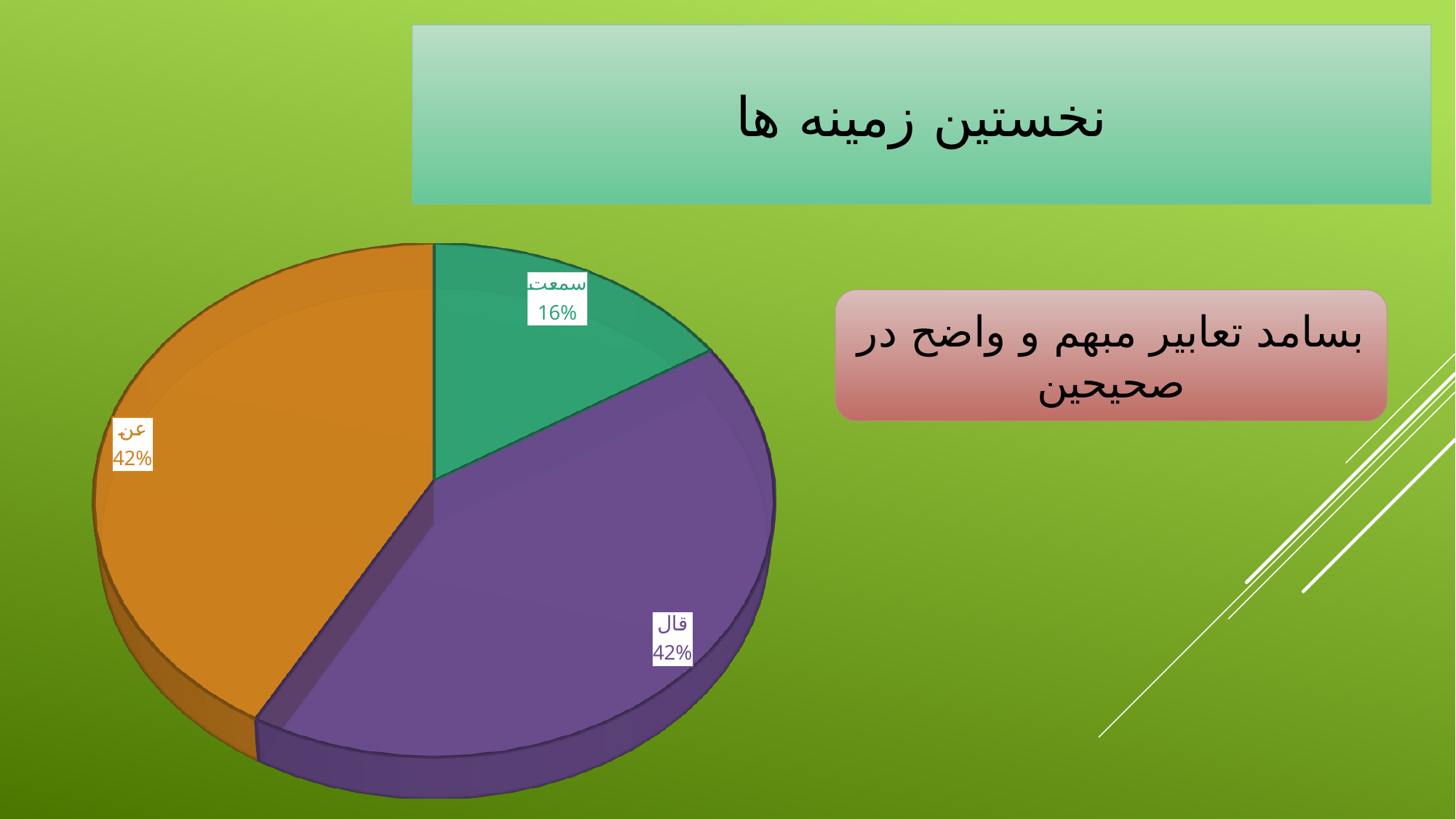
What colour is the سمعت slice? green What percentage is shown for the سمعت slice? 16% How many slices does the pie chart have? 3 What percentage is shown for the عن slice? 42% Which two slices of the pie chart have the same percentage? قال and عن What share of the pie does the عن slice represent? 42% What percentage is shown for the قال slice? 42% Which is larger, the قال slice or the سمعت slice? قال What kind of chart is shown on the slide? pie chart What colour is the قال slice? purple Which slice of the pie chart is the smallest? سمعت What is the difference in percentage points between the قال slice and the سمعت slice? 26%